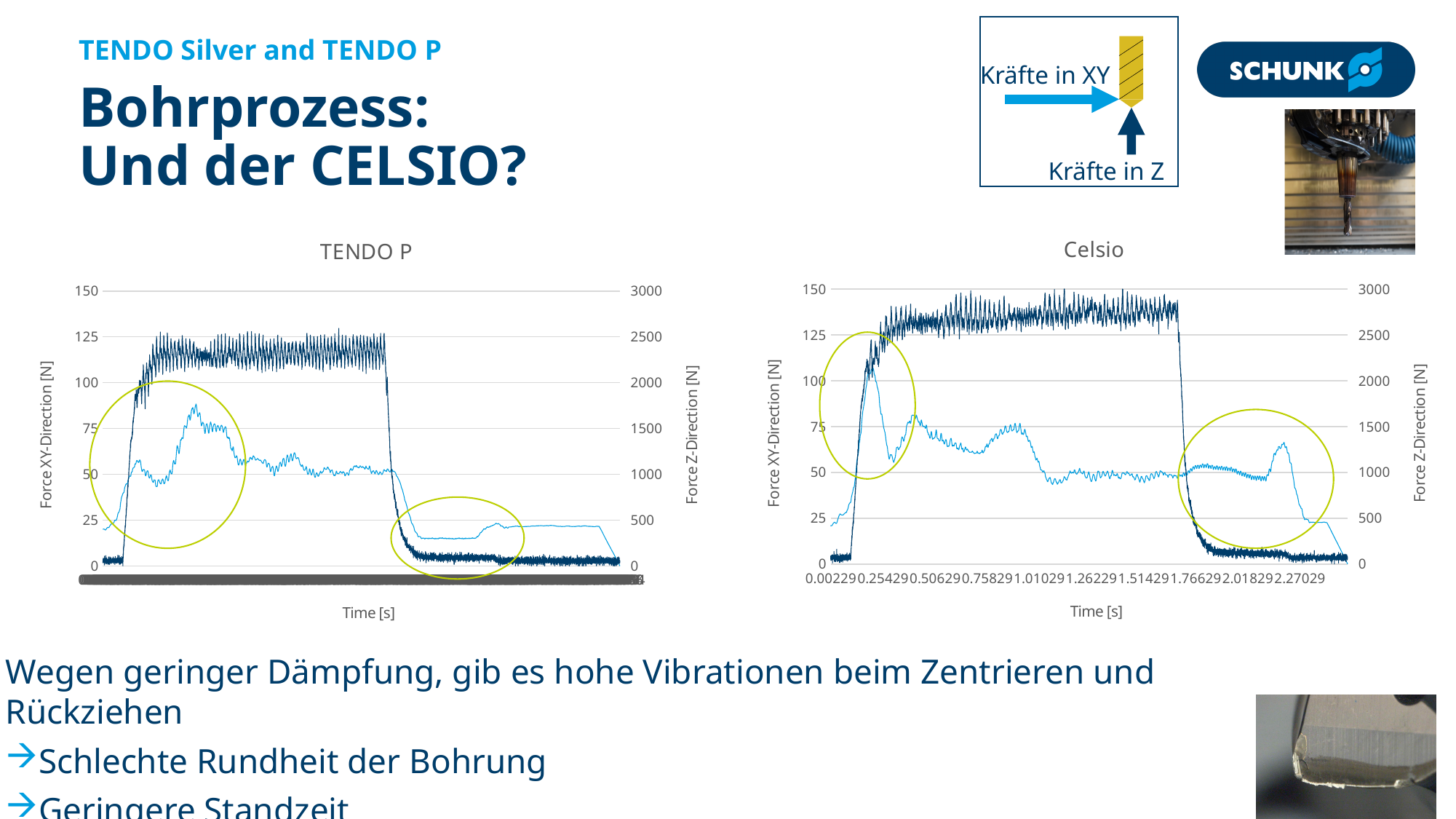
How many lines are plotted on the Celsio chart? 2 What kind of chart is the TENDO P chart? line chart What is the title of the chart on the left? TENDO P On the Celsio chart, is the peak of the light blue line greater or less than the 100 gridline on the left axis? greater On the Celsio chart, what is the highest tick value on the left axis (Force XY-Direction [N])? 150 On the TENDO P chart, is the peak of the light blue line greater or less than the 100 gridline on the left axis? less What is the title of the chart on the right? Celsio On the TENDO P chart, is the plateau of the dark blue line greater or less than the 100 gridline on the left axis? greater On the Celsio chart, what is the first tick label on the Time [s] axis? 0.00229 On the Celsio chart, what is the last tick label on the Time [s] axis? 2.27029 How many charts are shown on the slide? 2 On the TENDO P chart, what is the highest tick value on the right axis (Force Z-Direction [N])? 3000